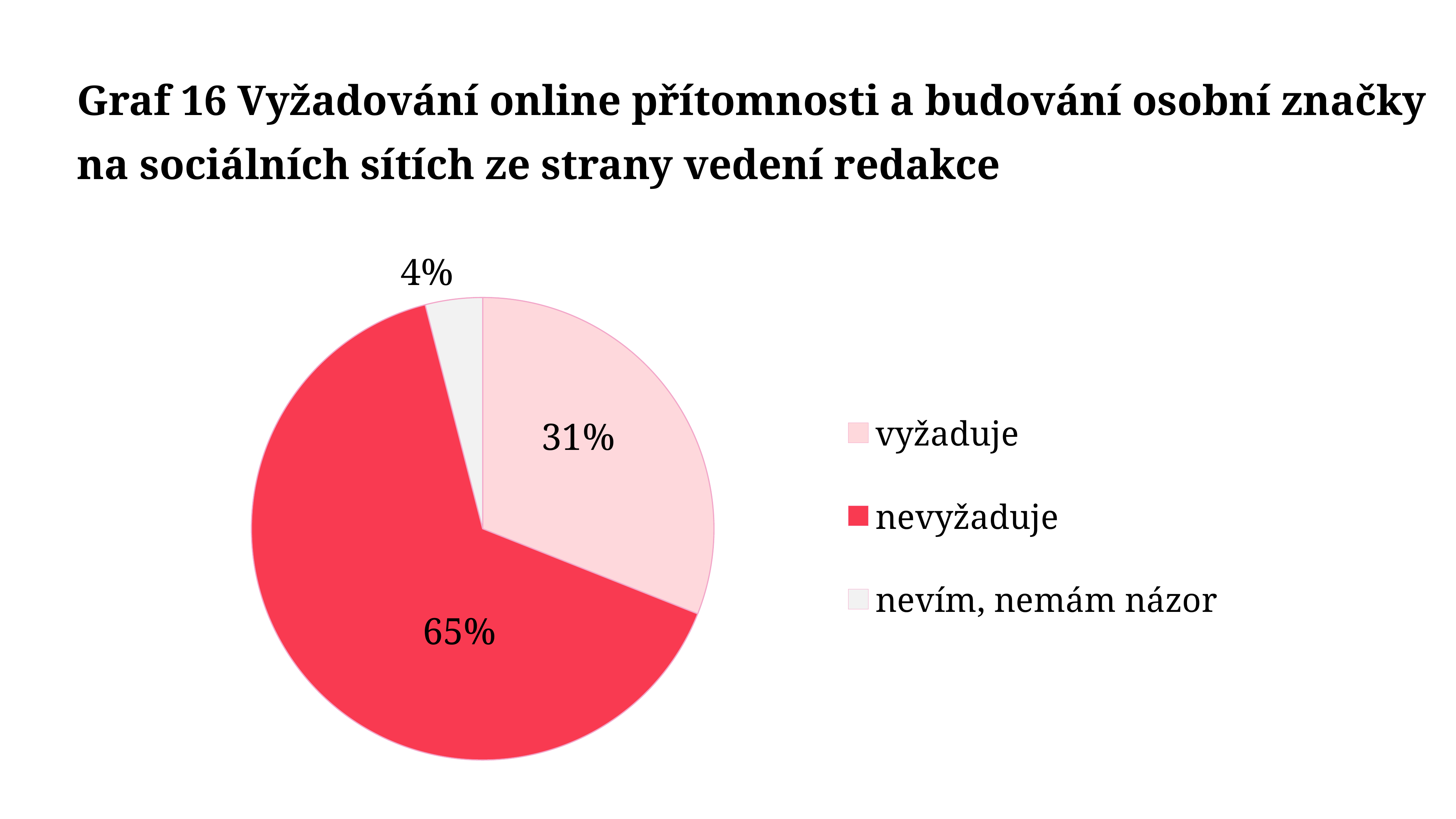
How many entries does the legend list? 3 What share of the pie does the "nevím, nemám názor" slice represent? 4% Which legend entry is shown in the darkest red colour? nevyžaduje What share of the pie does the "vyžaduje" slice represent? 31% Which slice is larger, "vyžaduje" or "nevím, nemám názor"? vyžaduje What share of the pie does the "nevyžaduje" slice represent? 65% What kind of chart is shown on the slide? pie chart What is the number of the graph given in the slide title? Graf 16 How many slices does the pie chart have? 3 Which category has the smallest slice of the pie? nevím, nemám názor Which category has the largest slice of the pie? nevyžaduje What is the difference in percentage points between the "nevyžaduje" and "vyžaduje" slices? 34